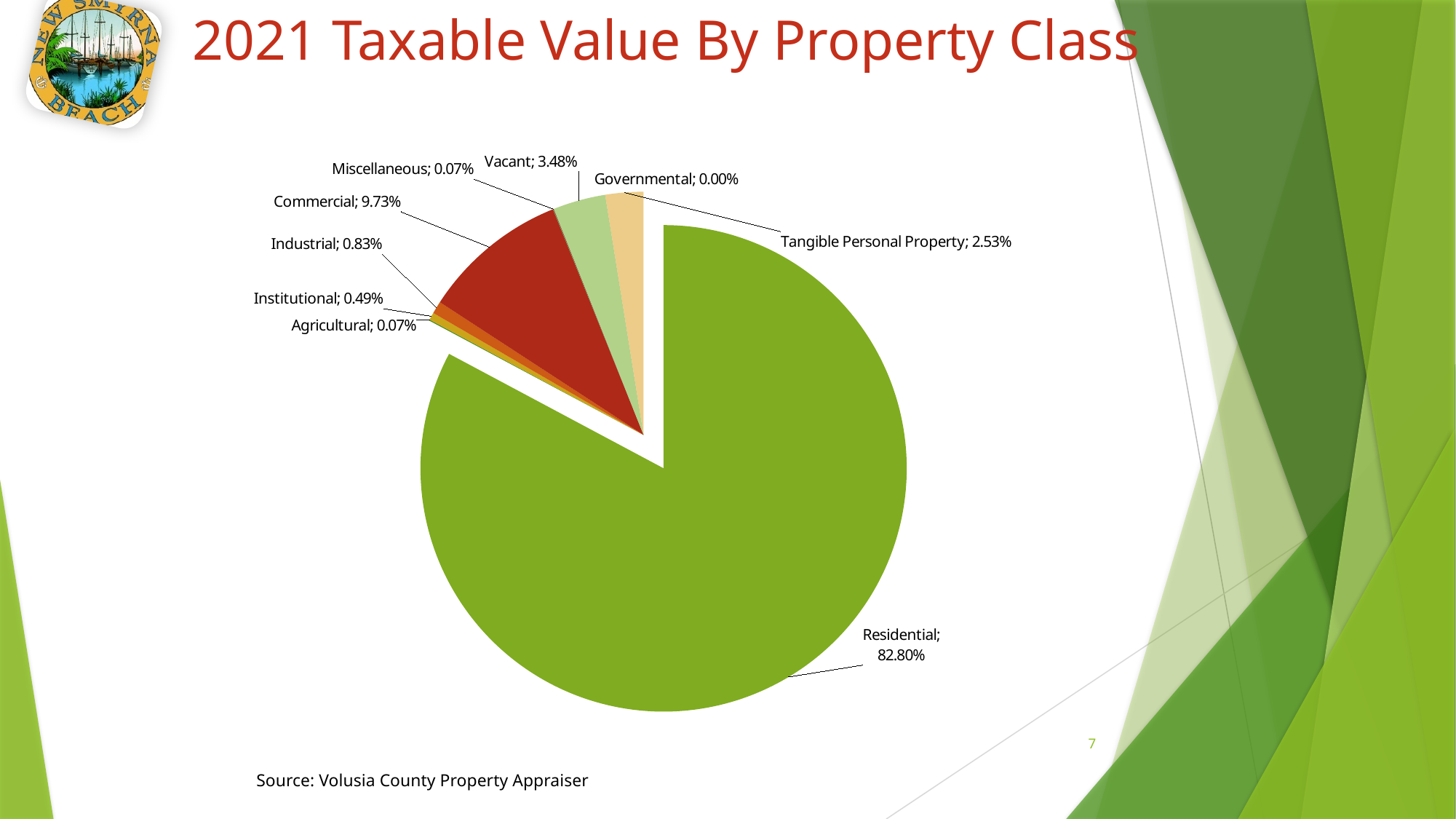
What is the difference in percentage points between the Residential and Commercial shares? 73.07 What share of the 2021 taxable value is Commercial? 9.73% Which property class has the largest share of the 2021 taxable value? Residential Which property class has the smallest share of the 2021 taxable value? Governmental What share of the 2021 taxable value is Tangible Personal Property? 2.53% What kind of chart is shown on the slide? Pie chart What share of the 2021 taxable value is Vacant property? 3.48% What is the title of the chart on the slide? 2021 Taxable Value By Property Class How many property classes are shown in the pie chart? 9 Which has a larger share of taxable value, Vacant or Tangible Personal Property? Vacant What share of the 2021 taxable value is Industrial? 0.83% What share of the 2021 taxable value is Residential? 82.80%